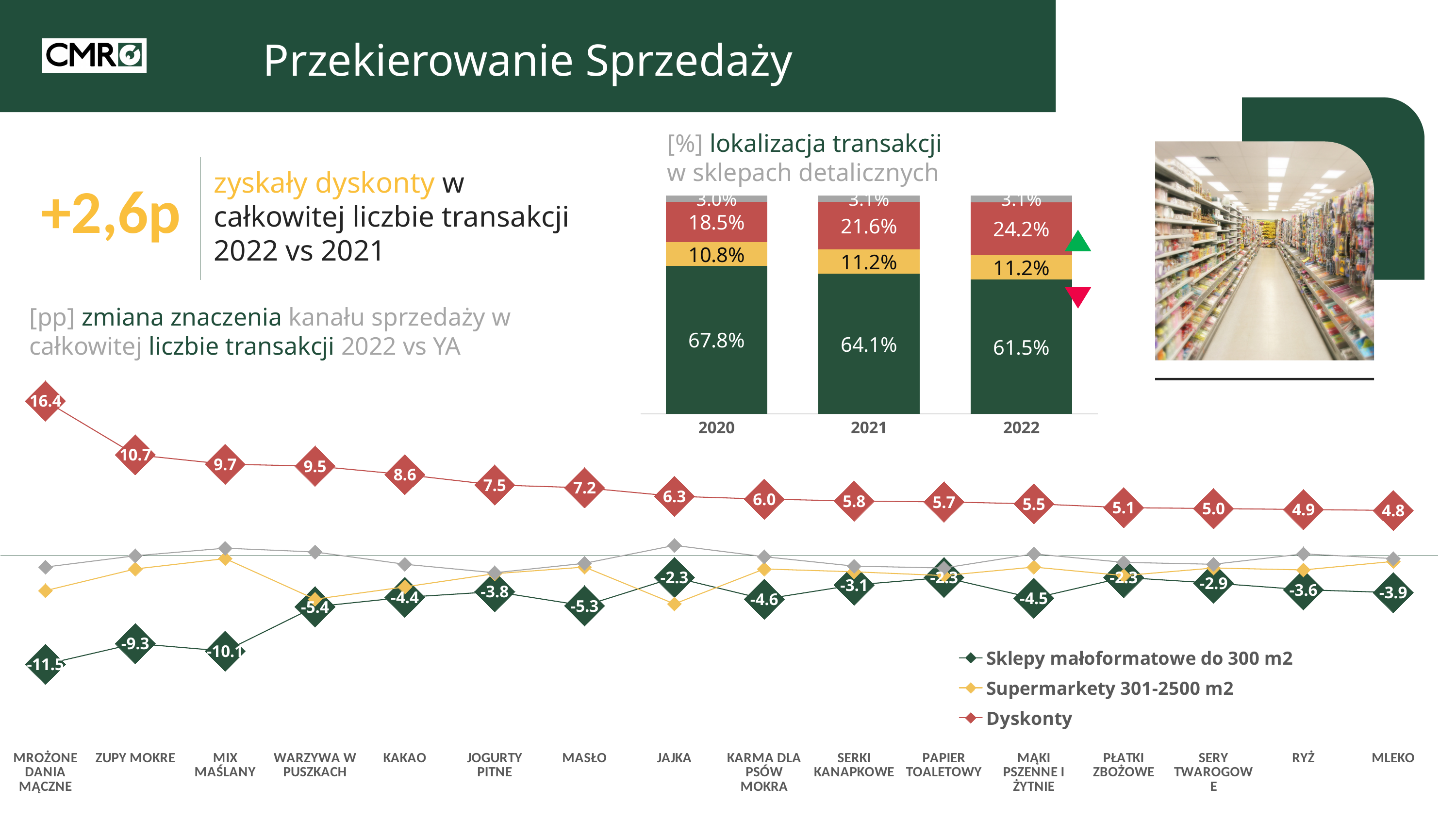
In the stacked bar chart '[%] lokalizacja transakcji w sklepach detalicznych', what is the value of the red segment for 2021? 21.6% In the line chart '[pp] zmiana znaczenia kanału sprzedaży', what is the difference between the Dyskonty values for MROŻONE DANIA MĄCZNE and MLEKO? 11.6 In the stacked bar chart '[%] lokalizacja transakcji w sklepach detalicznych', by how many percentage points did the red segment grow from 2020 to 2022? 5.7 In the stacked bar chart '[%] lokalizacja transakcji w sklepach detalicznych', what is the value of the bottom (dark green) segment for 2022? 61.5% In the line chart '[pp] zmiana znaczenia kanału sprzedaży', which category has the lowest value for Sklepy małoformatowe do 300 m2? MROŻONE DANIA MĄCZNE In the stacked bar chart '[%] lokalizacja transakcji w sklepach detalicznych', does the bottom dark green segment rise or fall from 2020 to 2022? fall In the line chart '[pp] zmiana znaczenia kanału sprzedaży', what is the Dyskonty value for KAKAO? 8.6 In the line chart '[pp] zmiana znaczenia kanału sprzedaży', how many product categories are shown on the x axis? 16 In the stacked bar chart '[%] lokalizacja transakcji w sklepach detalicznych', how many bars (years) are shown? 3 In the line chart '[pp] zmiana znaczenia kanału sprzedaży', which category has the highest Dyskonty value? MROŻONE DANIA MĄCZNE In the line chart '[pp] zmiana znaczenia kanału sprzedaży', how many series does the legend list? 3 In the line chart '[pp] zmiana znaczenia kanału sprzedaży', what is the value for Sklepy małoformatowe do 300 m2 for MASŁO? -5.3